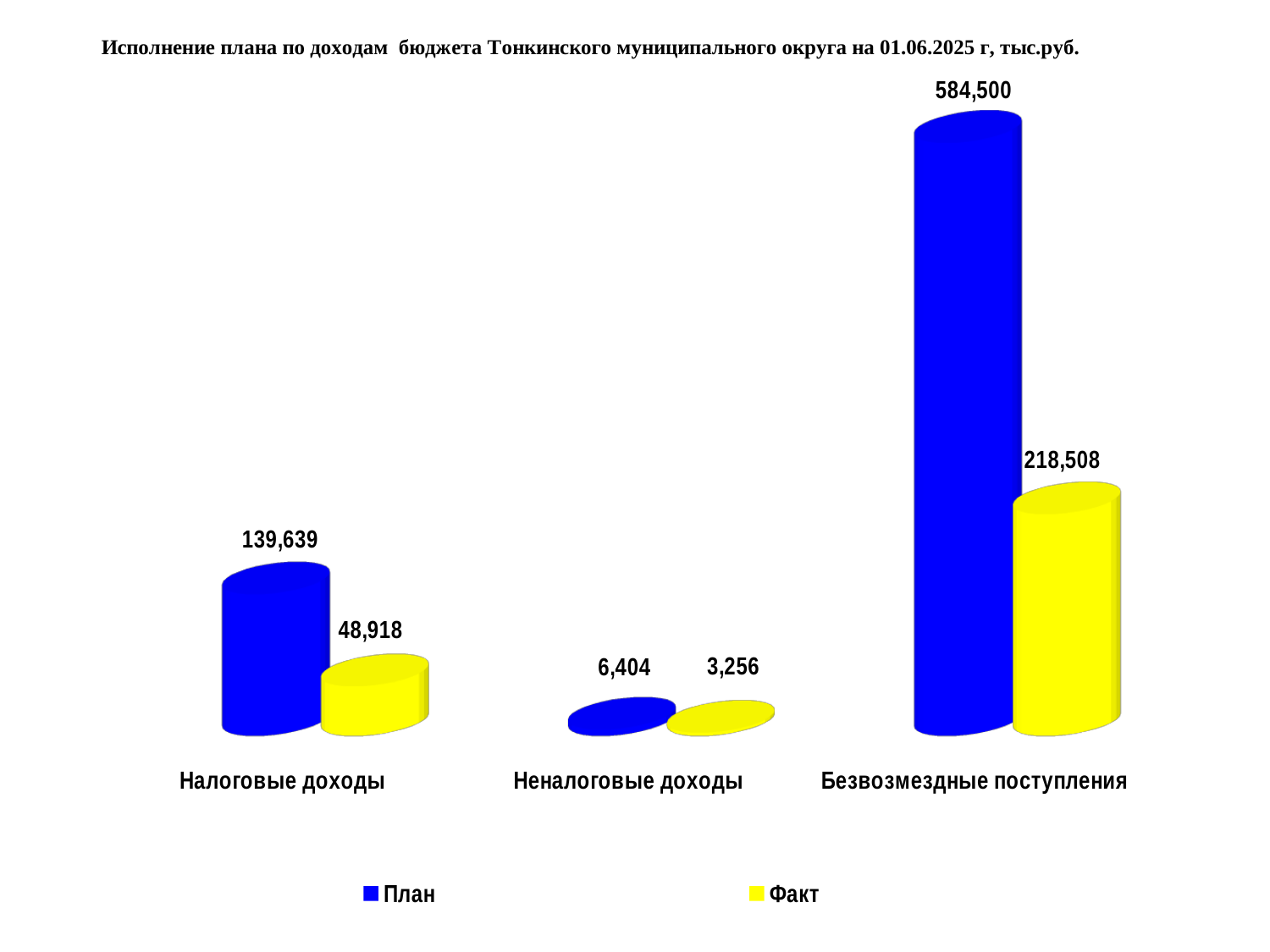
How many series does the legend list? 2 Which category has the highest План value? Безвозмездные поступления What is the difference between the План and Факт values for Налоговые доходы? 90,721 Which is larger: the Факт value for Налоговые доходы or the Факт value for Неналоговые доходы? Налоговые доходы What is the Факт value for Безвозмездные поступления? 218,508 What is the Факт value for Неналоговые доходы? 3,256 How many categories are shown on the x axis? 3 Which category has the lowest Факт value? Неналоговые доходы What kind of chart is shown on the slide? Bar chart What is the План value for Налоговые доходы? 139,639 Which colour represents the Факт series? Yellow What is the difference between the План and Факт values for Безвозмездные поступления? 365,992